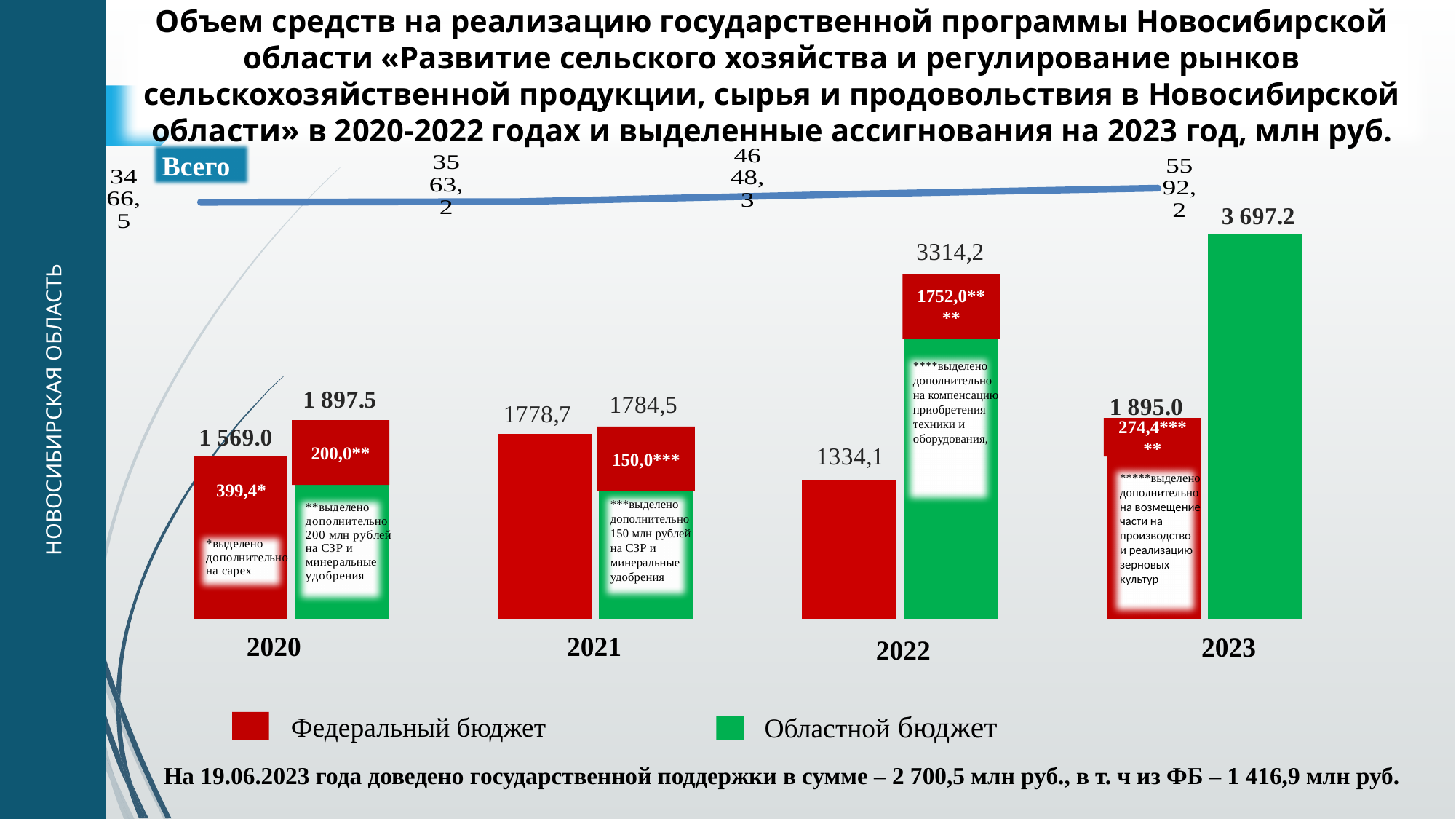
How many years are shown on the x axis? 4 What kind of chart is used for the budget values? Bar chart In which year is the Областной бюджет bar the highest? 2023 What is the value of the Федеральный бюджет bar for 2022? 1334,1 What is the value of the Областной бюджет bar for 2022? 3314,2 What is the value of the Областной бюджет bar for 2023? 3 697.2 In 2022, which is larger: Федеральный бюджет or Областной бюджет? Областной бюджет In which year is the Федеральный бюджет bar the lowest? 2022 What is the difference between the Областной бюджет and Федеральный бюджет values in 2022? 1980,1 What is the value of the Федеральный бюджет bar for 2020? 1 569.0 Does the Всего line rise or fall from 2020 to 2023? Rises How many series does the legend list? 2